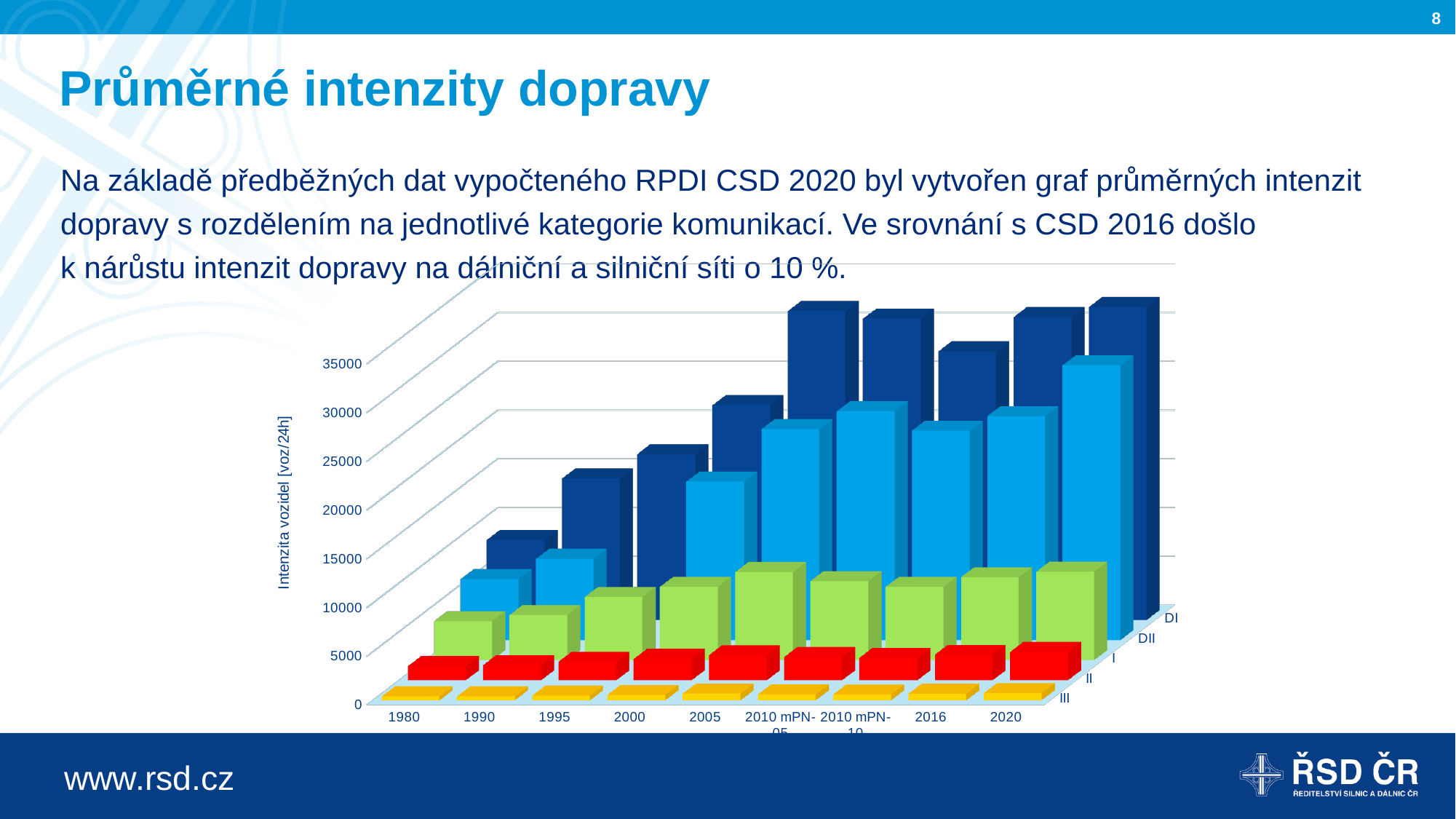
Is the value for the III series in 2020 greater or less than 5000? less Which series has the lowest values in the chart? III How many series does the chart show? 5 How many categories are shown along the x axis of the chart? 9 Which is larger for the DII series: the value for 1990 or the value for 2020? 2020 What is the label of the vertical axis of the chart? Intenzita vozidel [voz/24h] Which is larger for the DI series: the value for 1980 or the value for 2020? 2020 What kind of chart is shown on the slide? bar chart Do the values of the DI series generally rise or fall from 1980 to 2020? rise For the DI series, which category has the lowest value? 1980 Which series has the highest values in the chart? DI What is the first category label on the x axis of the chart? 1980